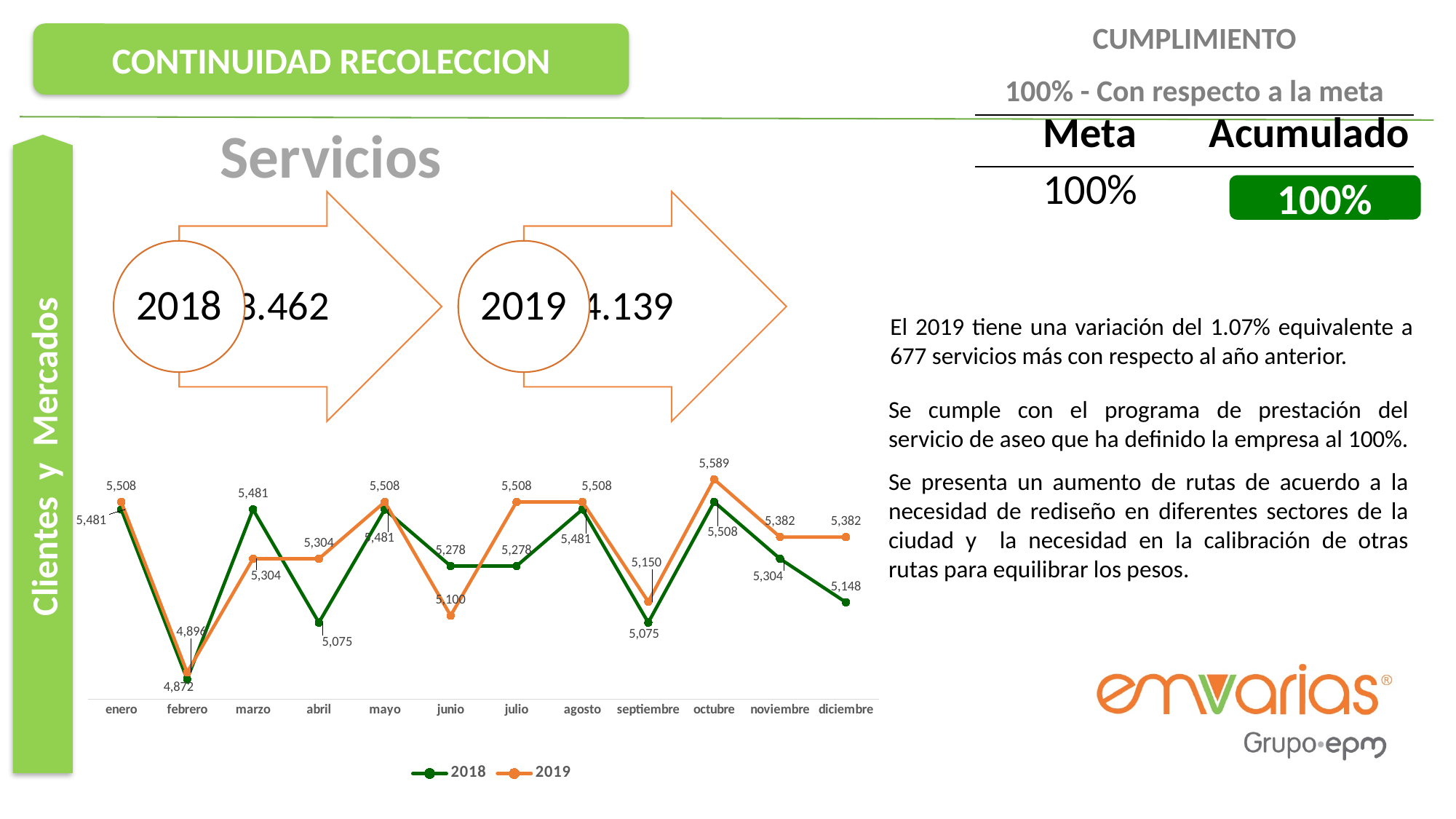
What is the value for 2019 in junio? 5,100 What is the difference between the 2019 and 2018 values in diciembre? 234 In which month is the 2019 series highest? octubre Which colour is used for the 2019 series in the chart? orange What kind of chart is shown on the slide? line chart Does the 2018 series rise or fall from octubre to diciembre? fall In which month is the 2018 series lowest? febrero Which series has the larger value in marzo, 2018 or 2019? 2018 What is the value for 2019 in octubre? 5,589 How many series does the chart legend list? 2 How many months are plotted along the x axis of the chart? 12 What is the value for 2018 in febrero? 4,872